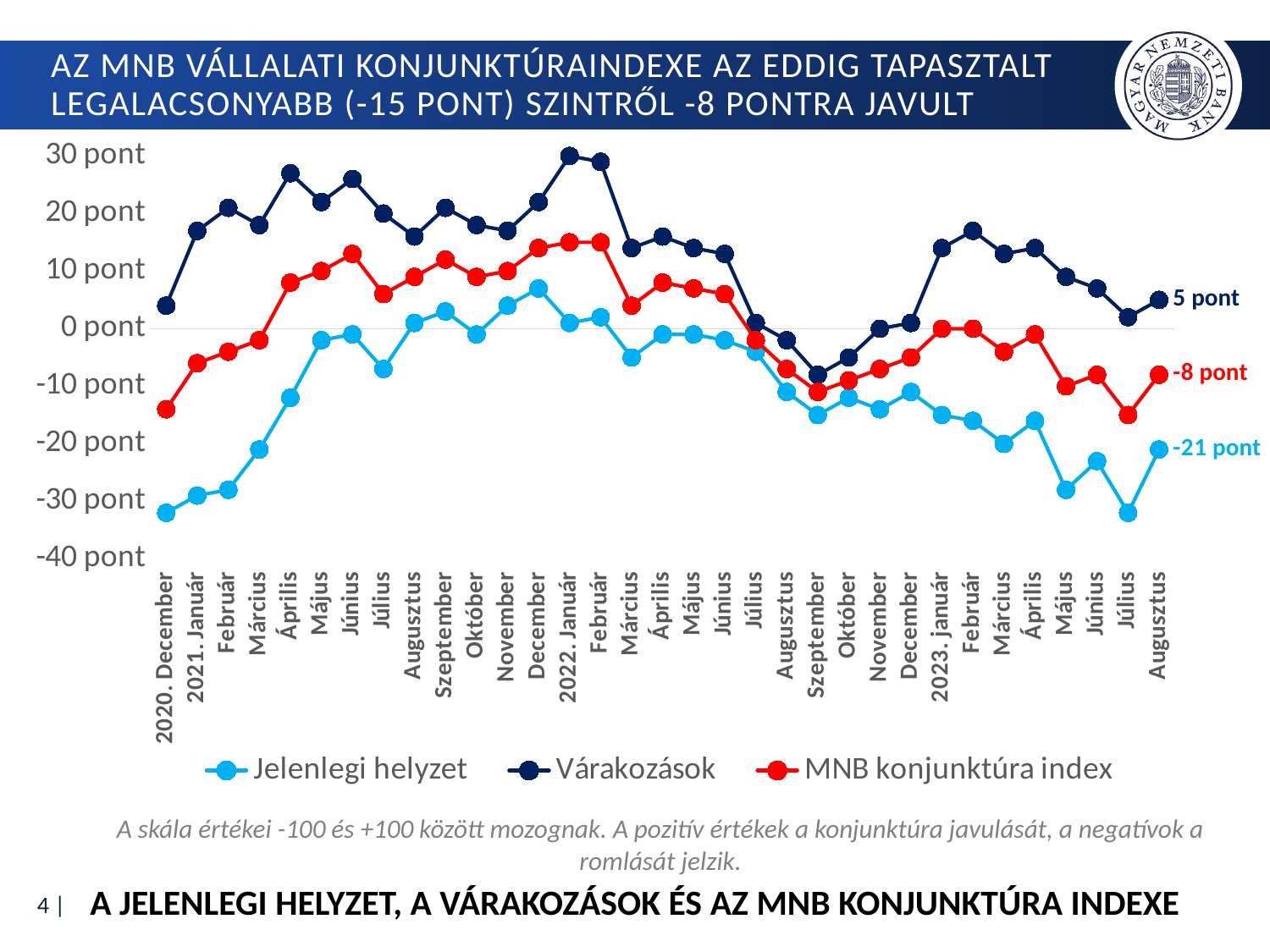
What is the value of the Várakozások series at 2023 Augusztus? 5 pont What is the value of the Jelenlegi helyzet series at 2023 Augusztus? -21 pont Is the Jelenlegi helyzet value at 2021. Január greater or less than -20 pont? less Which series has the lowest value at 2023 Augusztus? Jelenlegi helyzet What is the difference between the Várakozások value and the MNB konjunktúra index value at 2023 Augusztus? 13 pont What kind of chart is shown on the slide? Line chart How many series does the legend list? 3 What is the value of the MNB konjunktúra index at 2023 Augusztus? -8 pont Is the Várakozások value at 2022. Január greater or less than 20 pont? greater Does the Jelenlegi helyzet series rise or fall from 2020. December to 2021 Június? Rises At 2023 Augusztus, which is larger: Várakozások or Jelenlegi helyzet? Várakozások How many months (data points) are shown along the x axis? 33